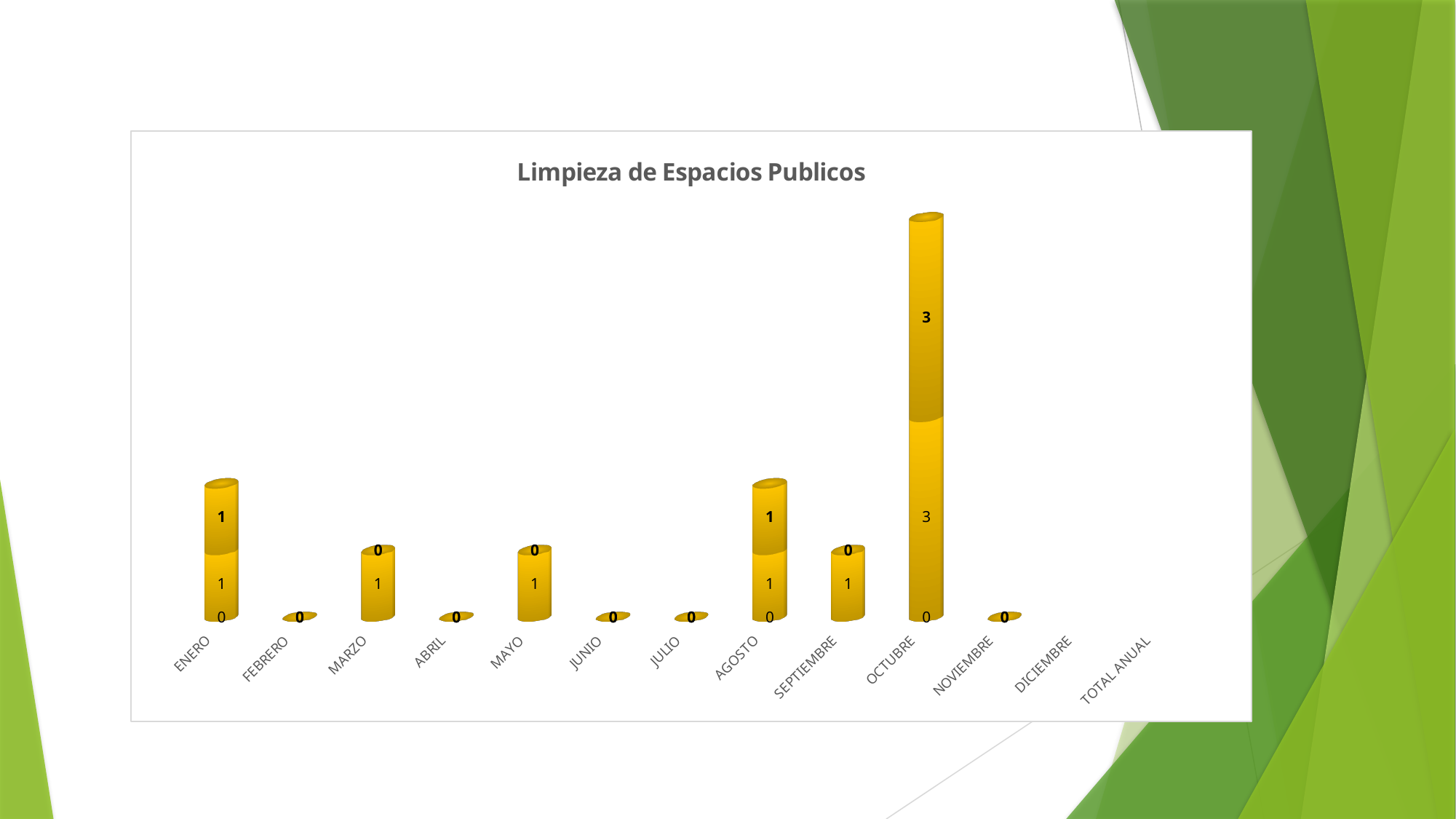
What is the difference between the total for OCTUBRE and the total for ENERO? 4 What kind of chart is shown on the slide? bar chart What is the total of the stacked bar for AGOSTO? 2 What value is printed on the top segment of the OCTUBRE bar? 3 Which bar is taller, MARZO or ABRIL? MARZO What is the title of the chart? Limpieza de Espacios Publicos What is the total of the stacked bar for OCTUBRE? 6 Which bar is taller, OCTUBRE or ENERO? OCTUBRE What value is printed for FEBRERO? 0 What value is printed on the lower segment of the ENERO bar? 1 Which category has the tallest bar in the chart? OCTUBRE How many categories are listed along the x axis of the chart? 13